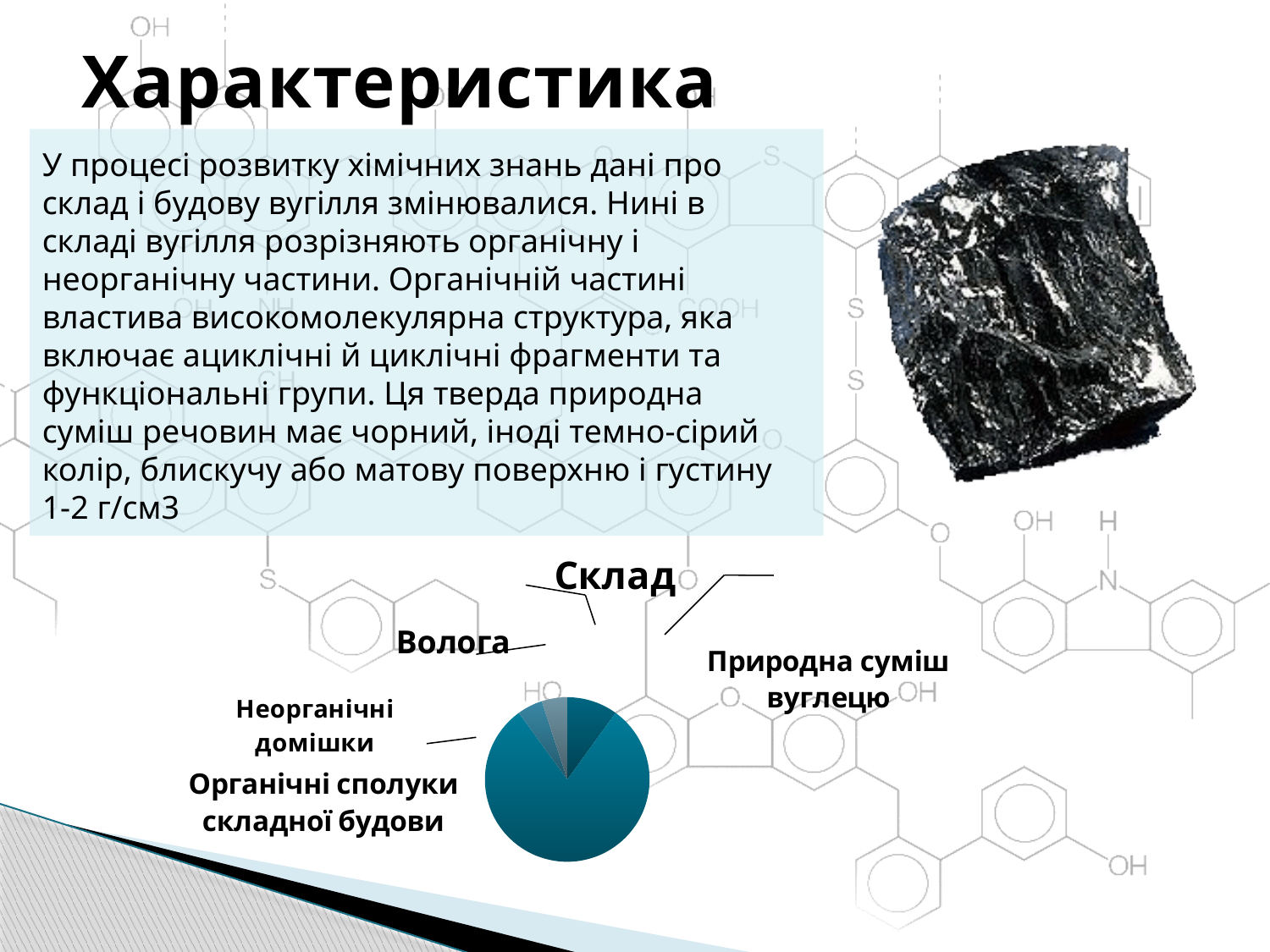
Which is larger in the pie chart: Органічні сполуки складної будови or Неорганічні домішки? Органічні сполуки складної будови Which slice of the pie chart is the largest? Органічні сполуки складної будови Which slice of the pie chart is the second largest? Природна суміш вуглецю What kind of chart is shown on the slide? pie chart How many slices does the pie chart have? 4 Which is larger in the pie chart: Природна суміш вуглецю or Вологa? Природна суміш вуглецю Which is larger in the pie chart: Органічні сполуки складної будови or Природна суміш вуглецю? Органічні сполуки складної будови What is the title of the pie chart? Склад Does the slice for Органічні сполуки складної будови take up more or less than half of the pie? more